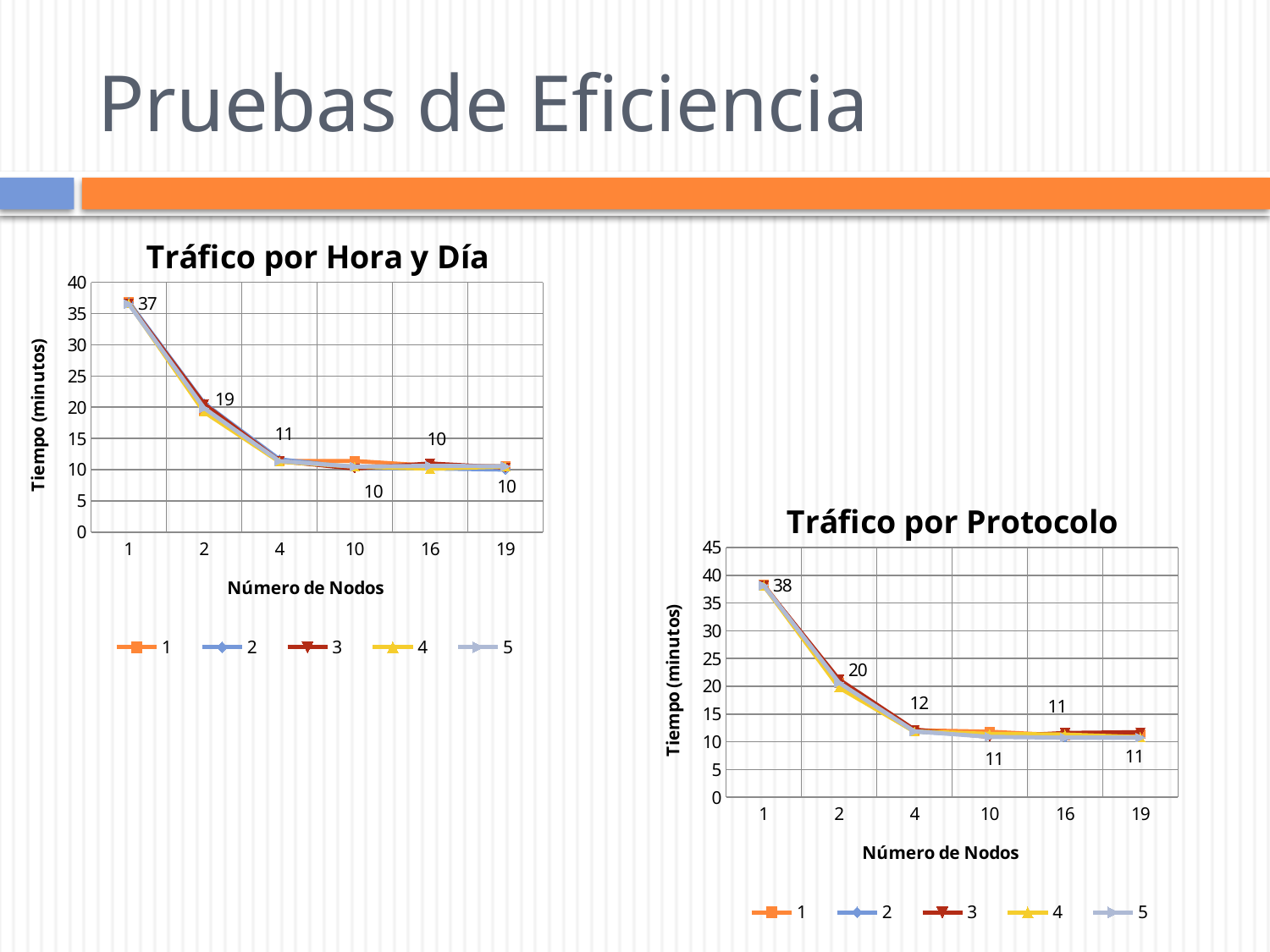
In "Tráfico por Protocolo", what value is labelled at 1 node? 38 In "Tráfico por Hora y Día", what value is labelled at 1 node? 37 In "Tráfico por Protocolo", what value is labelled at 4 nodes? 12 What is the y-axis title of "Tráfico por Protocolo"? Tiempo (minutos) How many series does the legend of "Tráfico por Protocolo" list? 5 How many node counts are shown on the x axis of "Tráfico por Hora y Día"? 6 In "Tráfico por Protocolo", is the value at 1 node greater or less than 35? greater In "Tráfico por Hora y Día", what is the difference between the labelled values at 1 node and 2 nodes? 18 What kind of chart is "Tráfico por Hora y Día"? line chart In "Tráfico por Hora y Día", what value is labelled at 2 nodes? 19 In "Tráfico por Hora y Día", do the values rise or fall as the number of nodes increases? fall Which is larger: the labelled value at 1 node in "Tráfico por Protocolo" or in "Tráfico por Hora y Día"? Tráfico por Protocolo